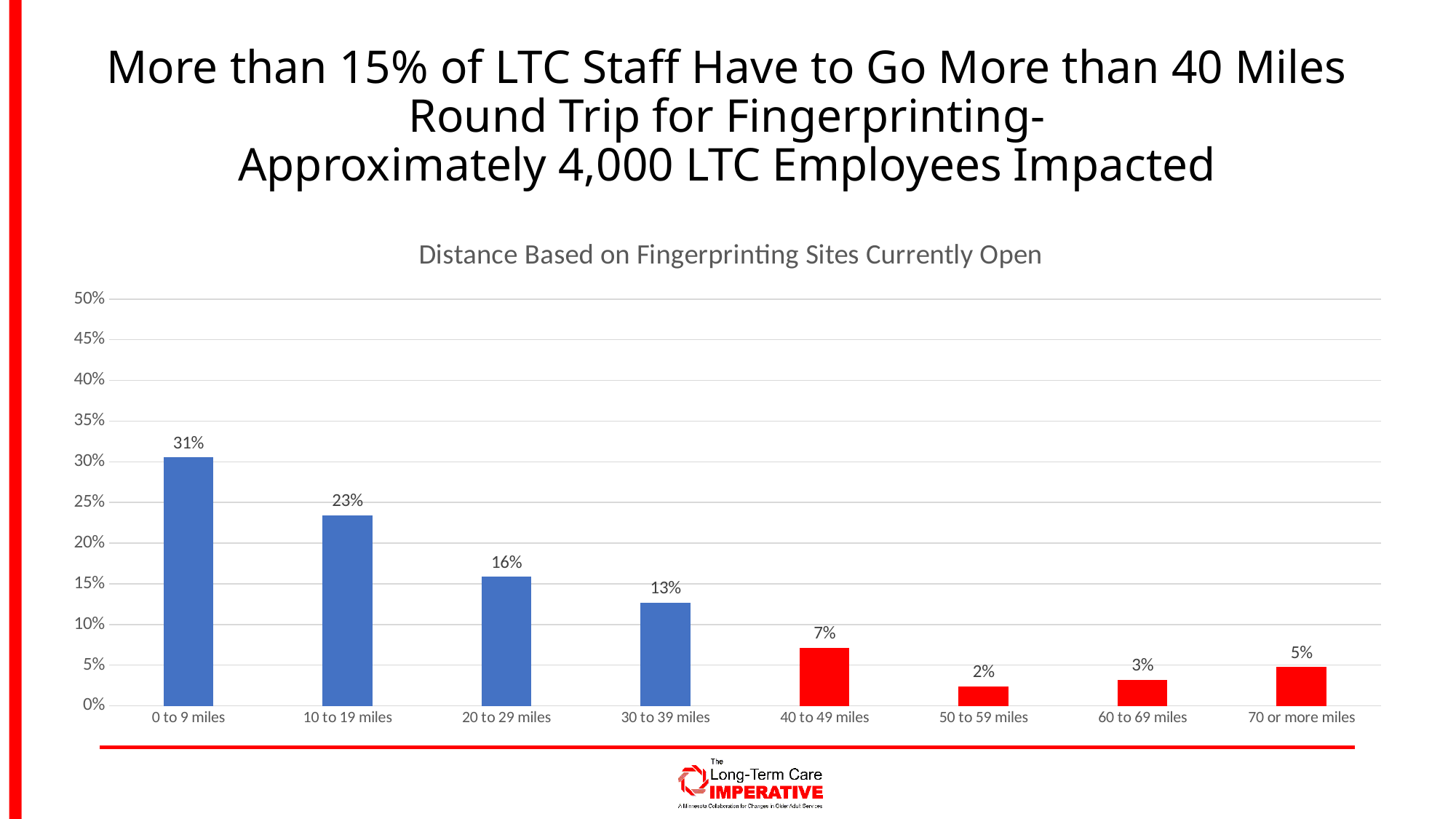
Is the value for 20 to 29 miles greater or less than 15%? greater Do the values generally rise or fall from 0 to 9 miles to 50 to 59 miles? Fall How many distance categories are shown on the x axis? 8 What is the value for 40 to 49 miles? 7% Which is larger, the value for 60 to 69 miles or the value for 70 or more miles? 70 or more miles What is the difference between the values for 0 to 9 miles and 10 to 19 miles? 8% Which distance category has the lowest value? 50 to 59 miles What is the value for 70 or more miles? 5% Which distance category has the highest value? 0 to 9 miles What is the value for 0 to 9 miles? 31% What kind of chart is shown on the slide? Bar chart What is the title of the chart? Distance Based on Fingerprinting Sites Currently Open